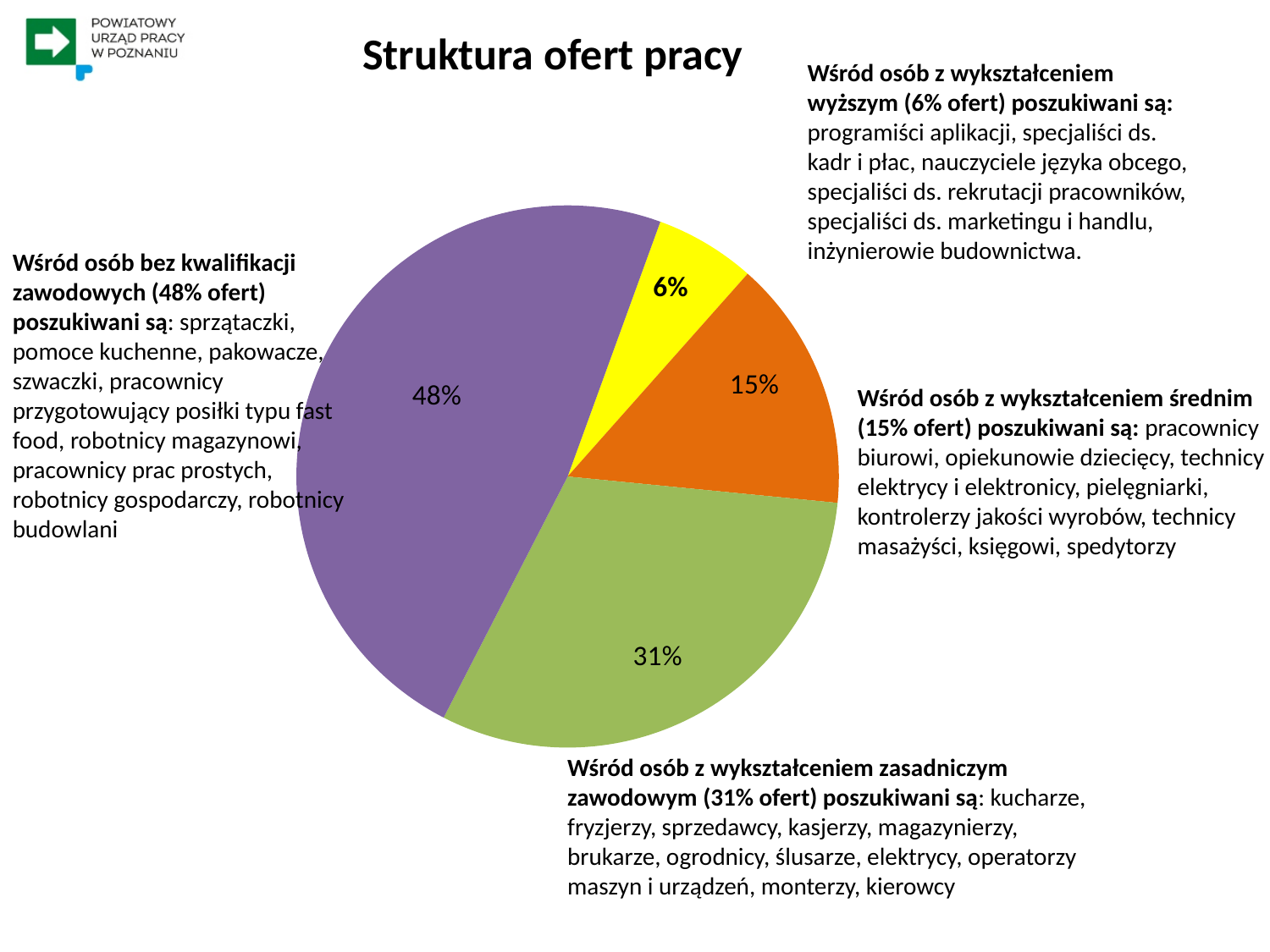
Which group has the smallest share of job offers? osoby z wykształceniem wyższym (6%) What share of job offers is for people with secondary education (wykształcenie średnie)? 15% Which is larger: the share for secondary education (średnie) or the share for higher education (wyższe)? secondary education (15%) What share of job offers is for people with higher education (wykształcenie wyższe)? 6% What colour is the slice labelled 6%? yellow How many slices does the pie chart have? 4 What share of job offers is for people without vocational qualifications (bez kwalifikacji zawodowych)? 48% What kind of chart is shown on the slide? pie chart Which group has the largest share of job offers? osoby bez kwalifikacji zawodowych (48%) What is the title of the chart? Struktura ofert pracy What is the difference in percentage points between the 48% slice and the 31% slice? 17